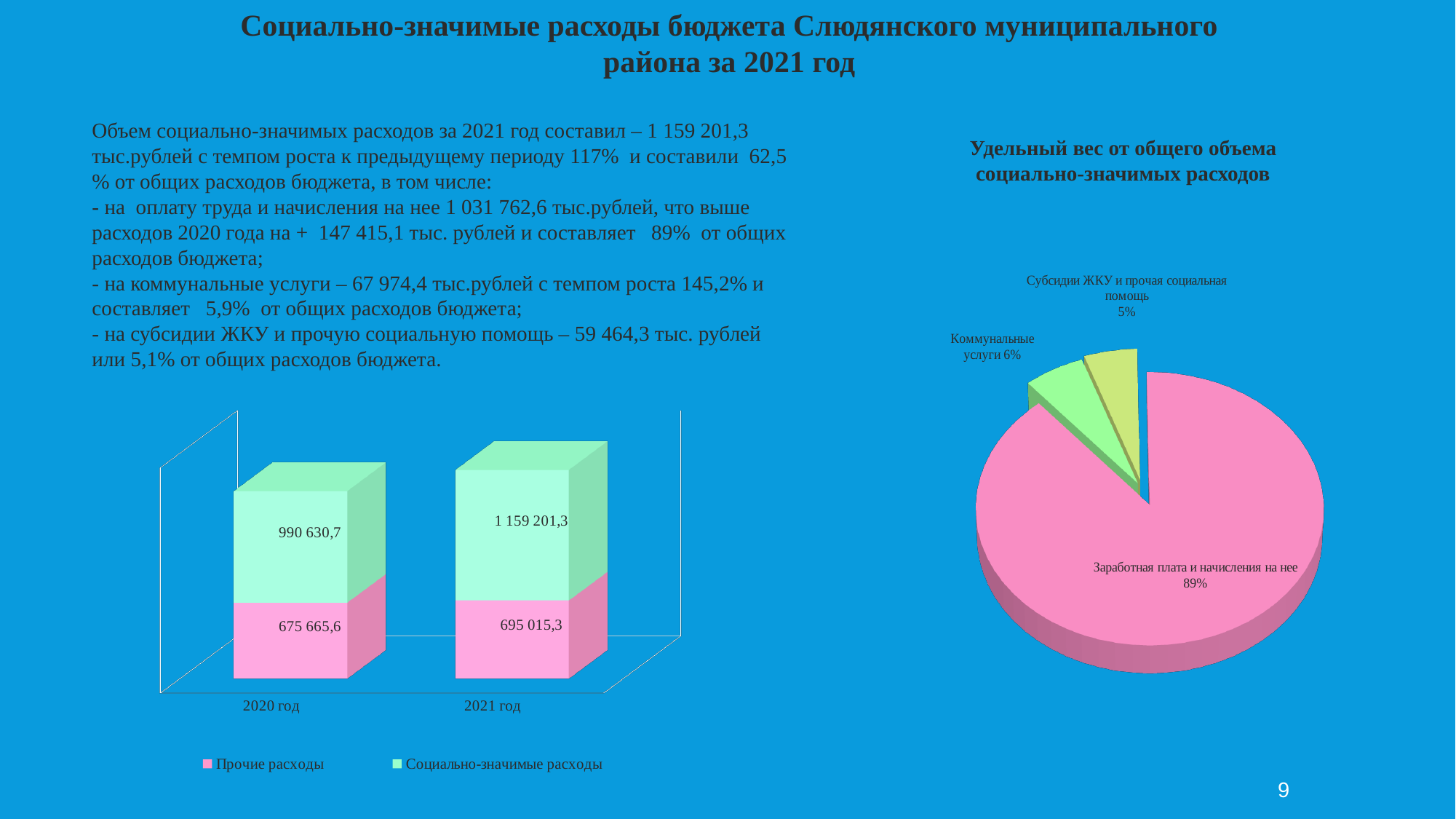
In the bar chart on the left, what is the total of the stacked bar for 2020 год? 1 666 296,3 In the pie chart 'Удельный вес от общего объема социально-значимых расходов', which category has the smallest share? Субсидии ЖКУ и прочая социальная помощь What type of chart is the chart titled 'Удельный вес от общего объема социально-значимых расходов'? pie chart In the bar chart on the left, what is the total of the stacked bar for 2021 год? 1 854 216,6 In the pie chart 'Удельный вес от общего объема социально-значимых расходов', which category has the largest share? Заработная плата и начисления на нее In the bar chart on the left, by how much did Социально-значимые расходы increase from 2020 год to 2021 год? 168 570,6 In the pie chart 'Удельный вес от общего объема социально-значимых расходов', what share does Коммунальные услуги have? 6% In the bar chart on the left, what is the value of Социально-значимые расходы for 2020 год? 990 630,7 In the bar chart on the left, which year has the larger value for Прочие расходы? 2021 год In the bar chart on the left, what is the value of Прочие расходы for 2020 год? 675 665,6 How many series does the legend of the bar chart on the left list? 2 In the bar chart on the left, what is the value of Социально-значимые расходы for 2021 год? 1 159 201,3